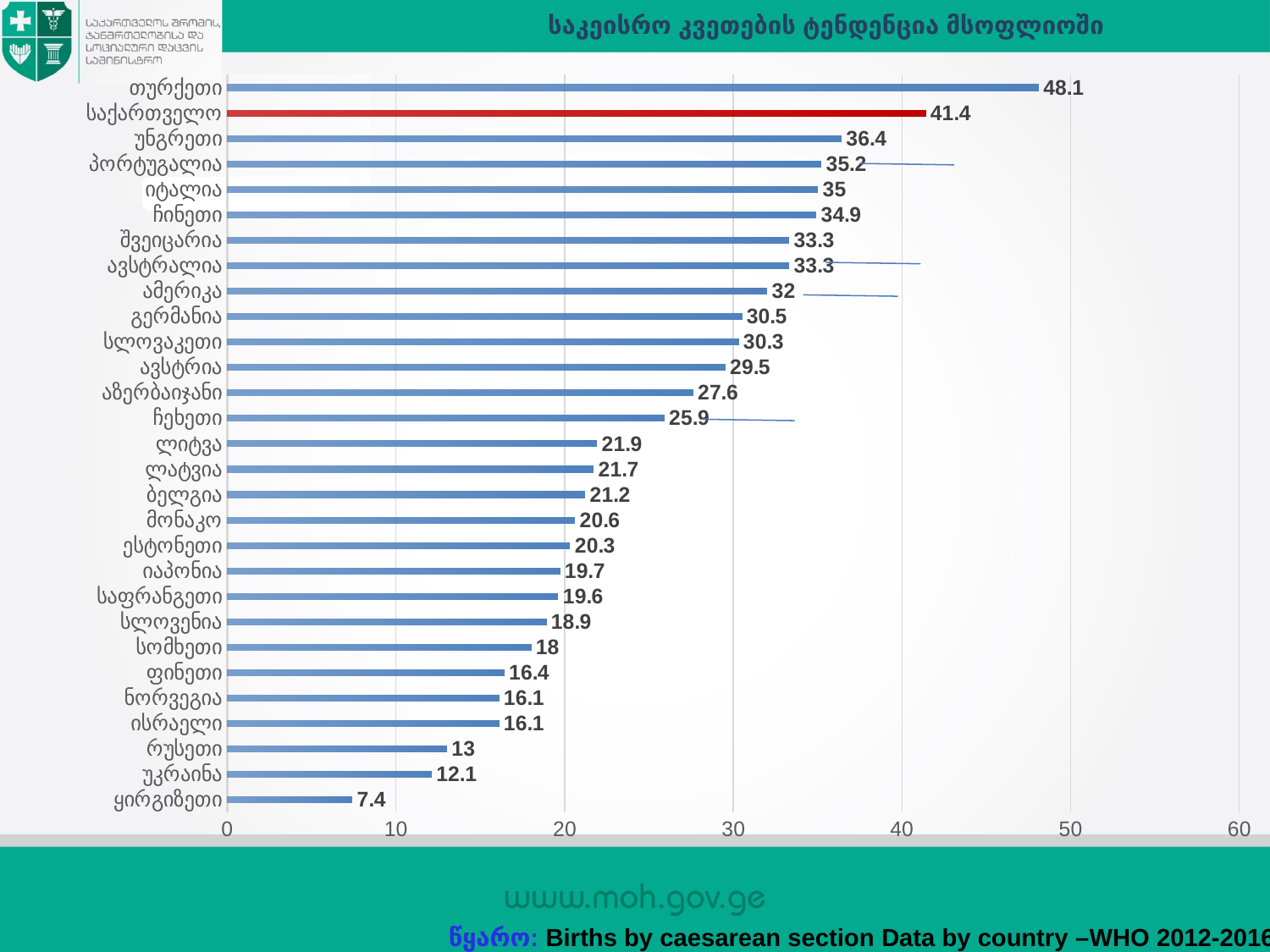
How many countries are shown in the chart? 29 Which has a larger value, გერმანია or ავსტრია? გერმანია What is the value for ჩინეთი? 34.9 Which bar is highlighted in red? საქართველო What is the value for ყირგიზეთი? 7.4 What kind of chart is shown on the slide? bar chart Which country has the highest value? თურქეთი Which country has the lowest value? ყირგიზეთი Is the value for ამერიკა greater or less than 30? greater What is the difference between the values for უკრაინა and რუსეთი? 0.9 What is the difference between the values for თურქეთი and საქართველო? 6.7 What is the value for საქართველო? 41.4